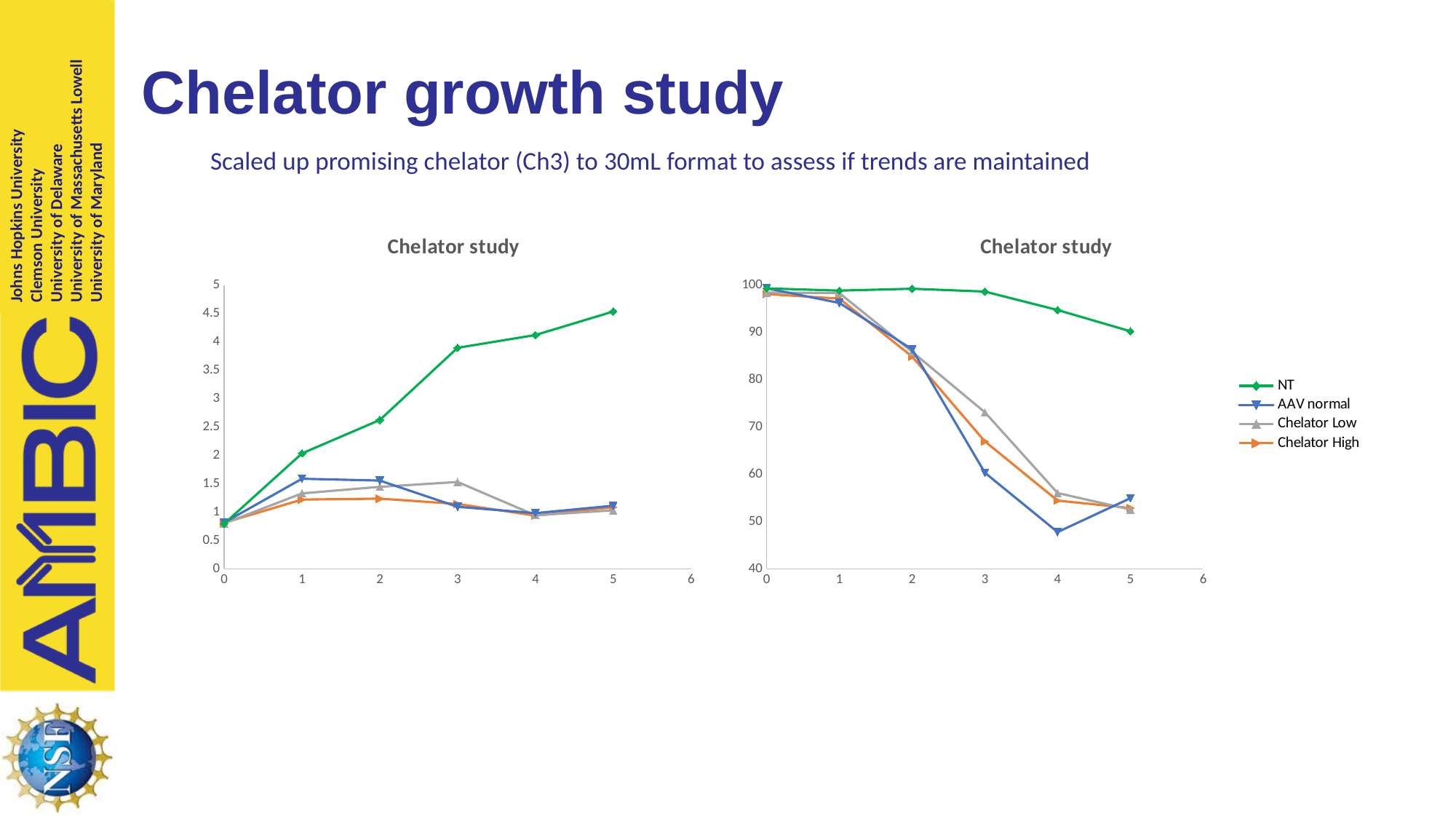
In the right chart, is the value for AAV normal at x = 4 greater or less than 50? less How many data points does each series have in the left chart? 6 In the left chart, is the value for Chelator High at x = 2 greater or less than 1.5? less What kind of chart is the left chart titled "Chelator study"? line chart How many series does the legend list? 4 In the left chart, is the value for NT at x = 3 greater or less than 3? greater In the right chart, does the Chelator High series rise or fall from x = 0 to x = 5? fall In the right chart, at x = 3, which is larger: Chelator Low or AAV normal? Chelator Low In the left chart, does the NT series rise or fall from x = 0 to x = 5? rise In the right chart, which series has the lowest value at x = 4? AAV normal In the left chart, which series has the highest value at x = 5? NT